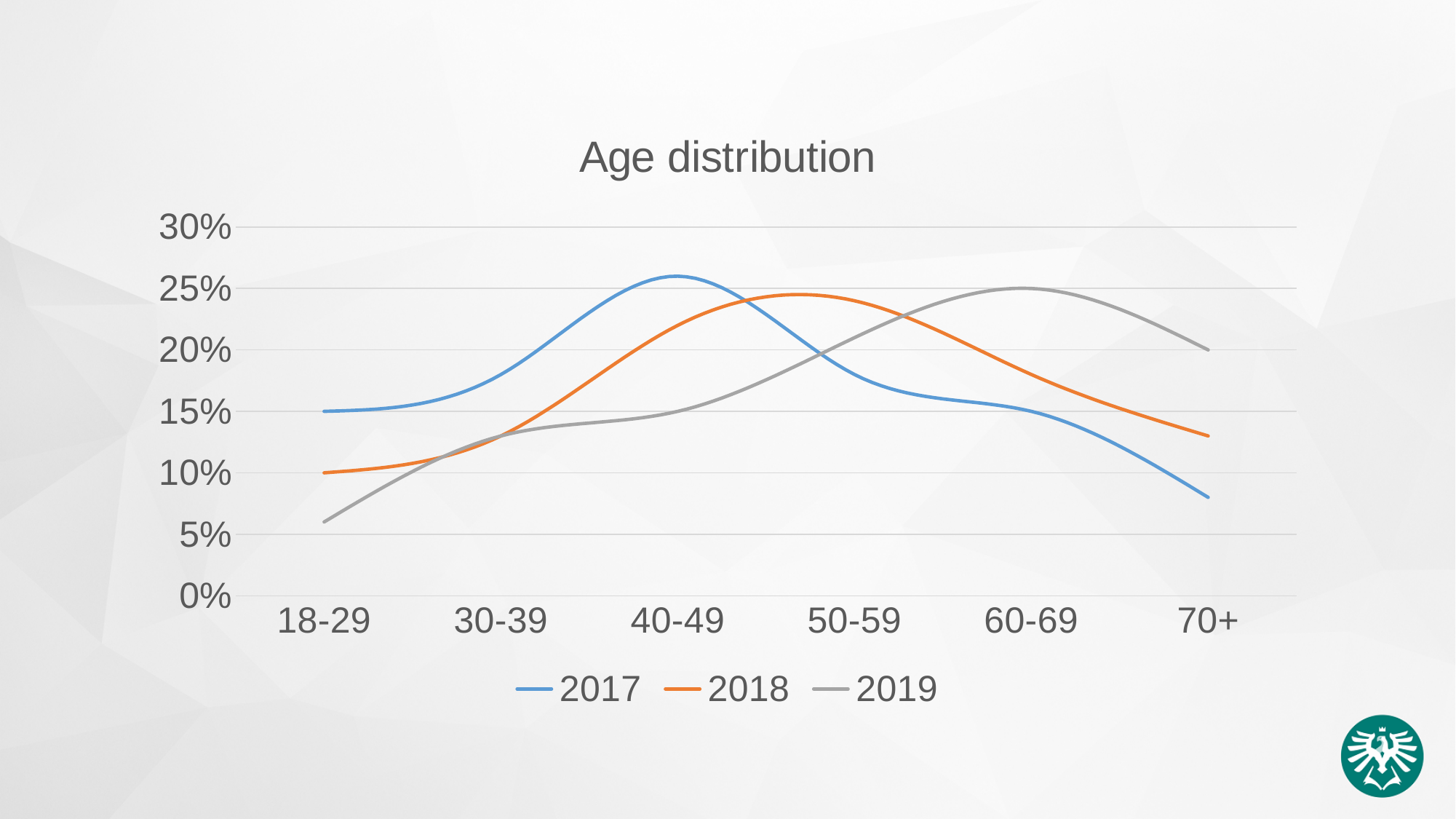
Is the value for 2017 in the 70+ age group greater or less than 10%? less In which age group does the 2019 series reach its highest value? 60-69 In which age group does the 2017 series reach its highest value? 40-49 What is the value for 2019 in the 70+ age group? 20% In which age group is the 2019 series lowest? 18-29 What is the value for 2017 in the 18-29 age group? 15% How many age categories are shown on the x axis? 6 What is the value for 2018 in the 18-29 age group? 10% How many series does the legend list? 3 What is the title of the chart? Age distribution In the 70+ age group, which series has the larger value, 2017 or 2019? 2019 What kind of chart is shown on the slide? line chart